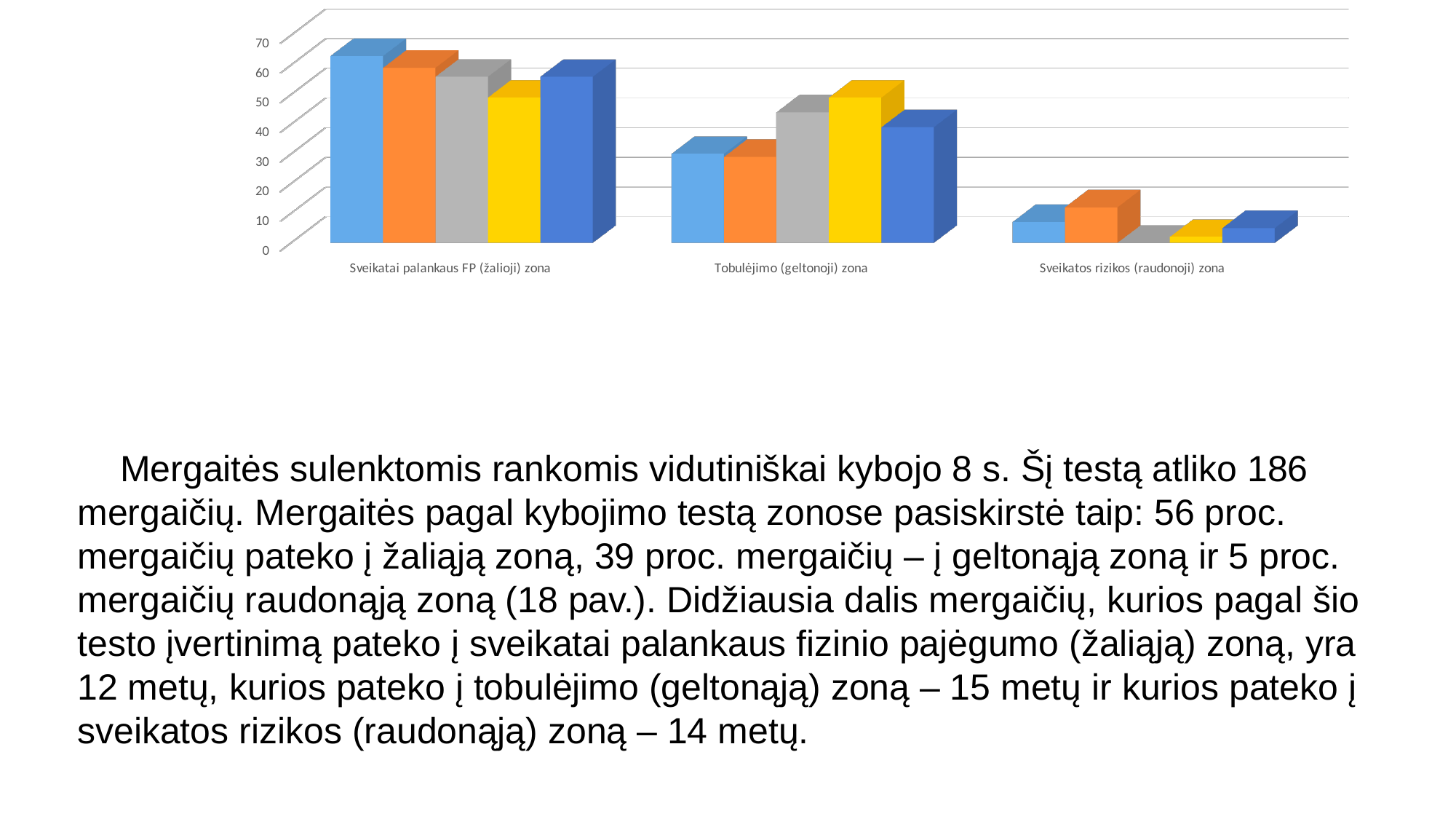
What kind of chart is shown on the slide? bar chart Which category has the shortest bars in the chart? Sveikatos rizikos (raudonoji) zona In the Tobulėjimo (geltonoji) zona category, which bar is taller: the yellow bar or the light blue bar? the yellow bar In the Sveikatos rizikos (raudonoji) zona category, which bar is taller: the orange bar or the gray bar? the orange bar Do the bar values generally rise or fall moving from left to right across the categories? fall Is the value of the gray bar for Tobulėjimo (geltonoji) zona greater or less than 30? greater Is the value of the light blue bar for Sveikatai palankaus FP (žalioji) zona greater or less than 50? greater Is the value of the dark blue bar for Sveikatai palankaus FP (žalioji) zona greater or less than 40? greater How many categories are shown on the x axis of the chart? 3 How many bars are plotted for each category in the chart? 5 Which category has the tallest bars in the chart? Sveikatai palankaus FP (žalioji) zona